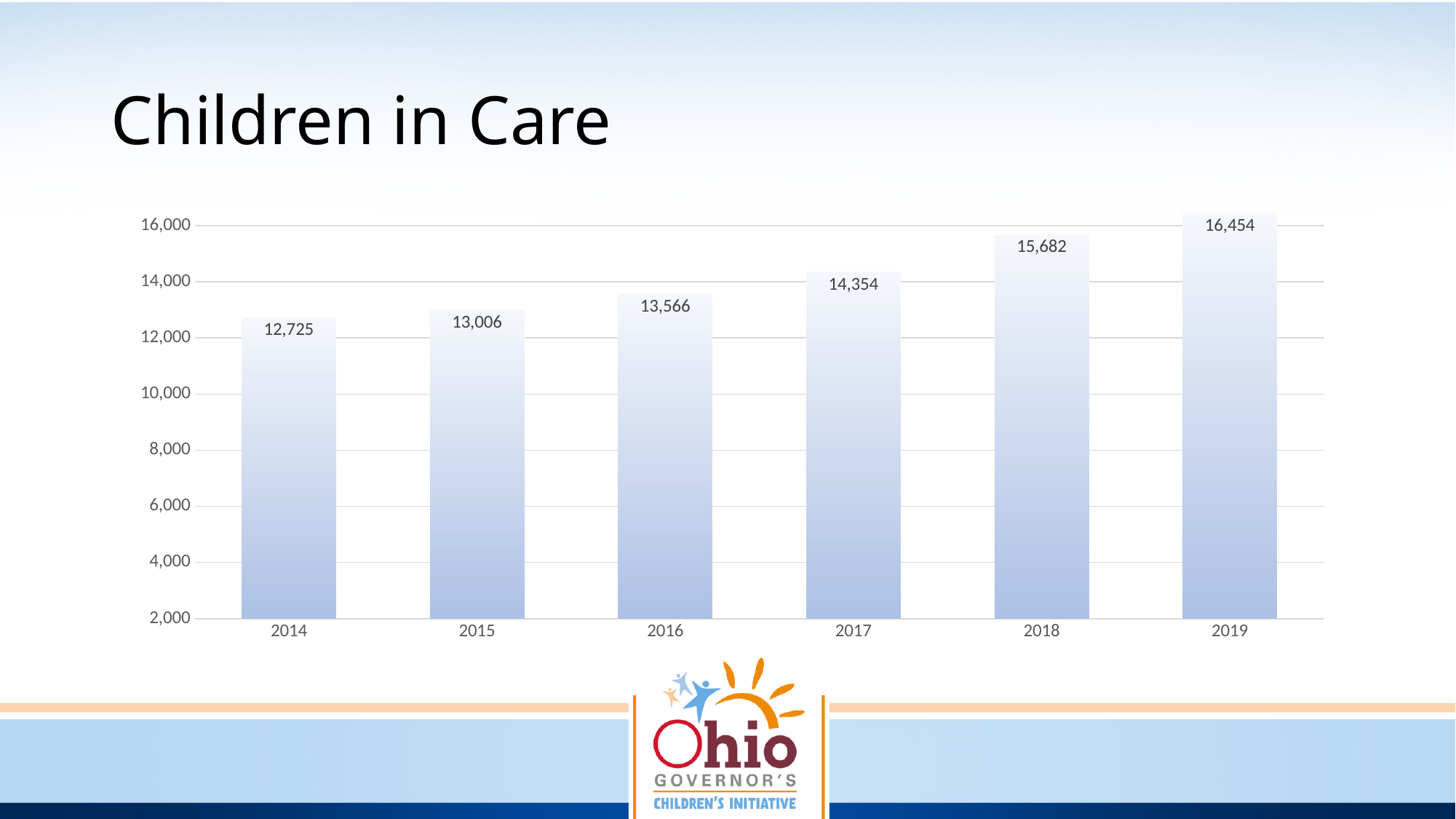
Which year has the lowest value? 2014 What is the value for 2019? 16,454 Which year has the highest value? 2019 What is the value for 2017? 14,354 Which is larger, the value for 2016 or the value for 2018? 2018 What kind of chart is shown on the slide? bar chart What is the value for 2014? 12,725 Do the values rise or fall from 2014 to 2019? rise What is the difference between the values for 2019 and 2018? 772 Is the value for 2017 greater or less than 14,000? greater What is the difference between the values for 2016 and 2015? 560 How many years are shown on the x axis? 6